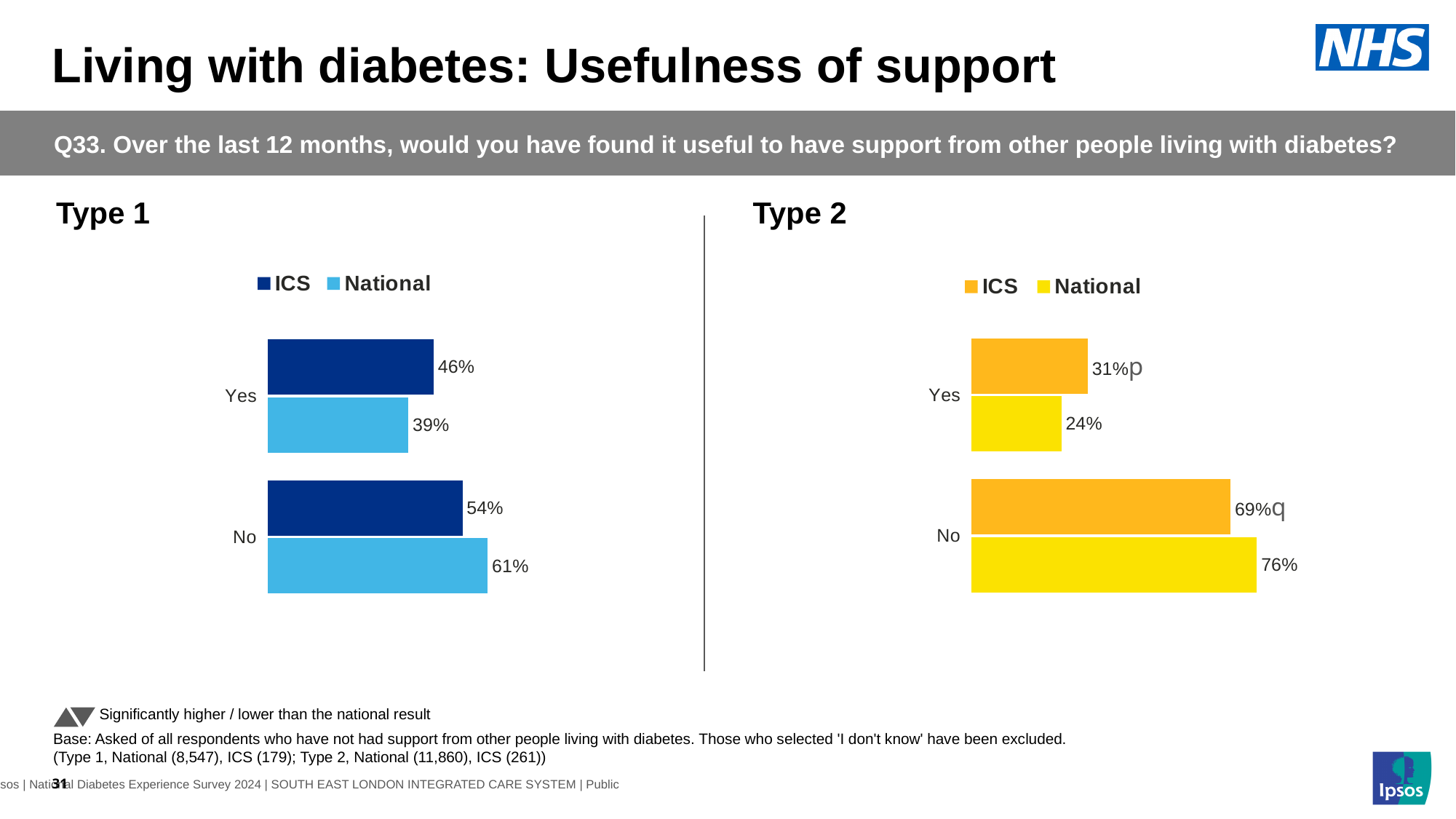
In the Type 2 chart, what is the National value for No? 76% In the Type 1 chart, what is the ICS value for Yes? 46% In the Type 2 chart, what is the difference between the ICS and National values for Yes? 7 percentage points In the Type 2 chart, what is the ICS value for Yes? 31% In the Type 2 chart, which is larger for No: the ICS value or the National value? National How many series does the legend of the Type 1 chart list? 2 In the Type 2 chart, what is the National value for Yes? 24% In the Type 1 chart, what is the National value for No? 61% In the Type 1 chart, which is larger for Yes: the ICS value or the National value? ICS In the Type 2 chart, which bar has the highest value? National, No (76%) In the Type 1 chart, what is the difference between the National and ICS values for No? 7 percentage points What type of chart is the Type 2 chart? Bar chart